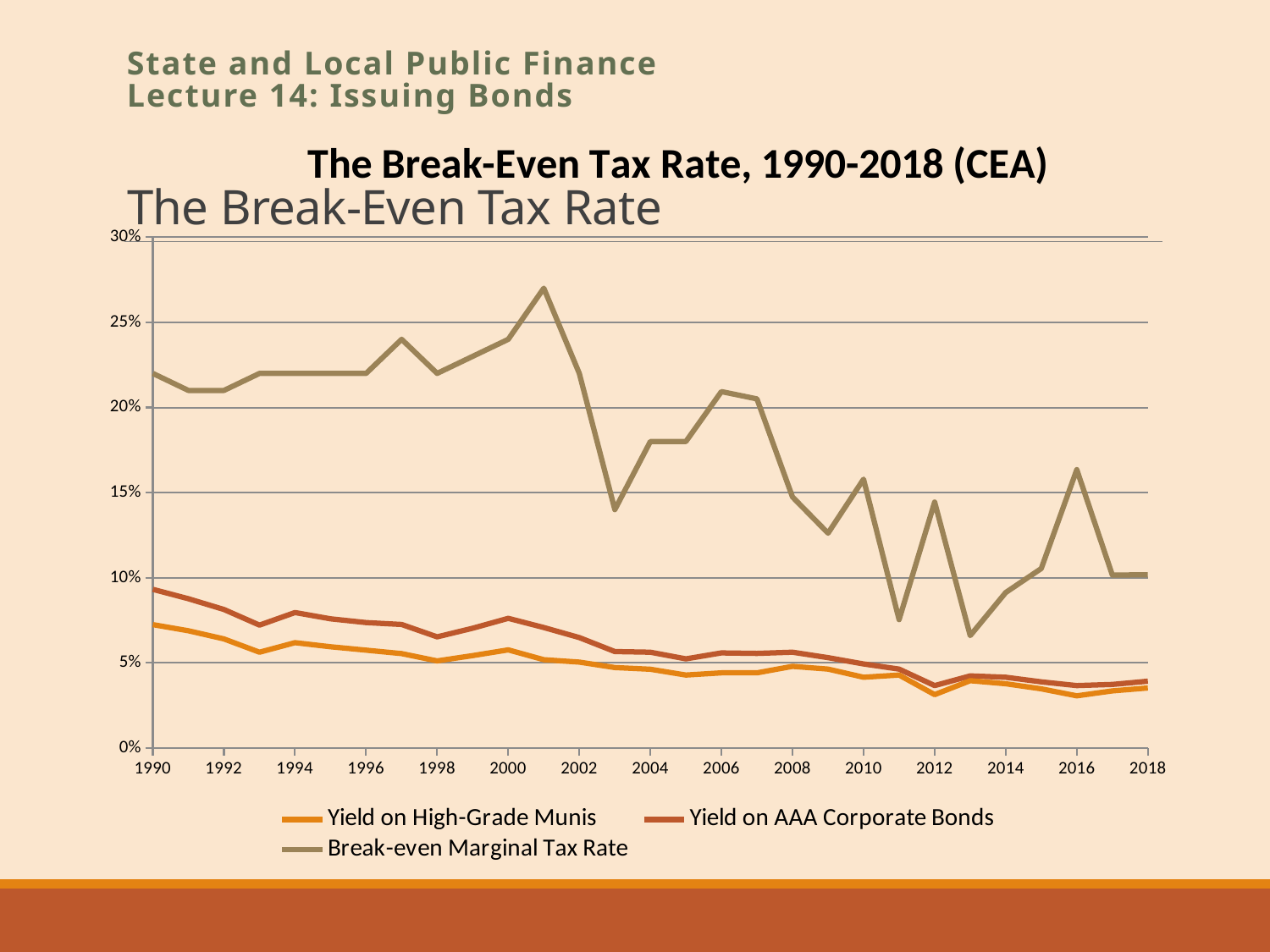
In 1990, which is higher: the Yield on AAA Corporate Bonds or the Yield on High-Grade Munis? Yield on AAA Corporate Bonds Is the Break-even Marginal Tax Rate in 2013 greater or less than 10%? less How many series does the legend list? 3 Which series is drawn in the orange line? Yield on High-Grade Munis What kind of chart is shown on the slide? line chart What is the title printed above the chart? The Break-Even Tax Rate, 1990-2018 (CEA) In which year does the Break-even Marginal Tax Rate reach its lowest value? 2013 Does the Break-even Marginal Tax Rate generally rise or fall from 1990 to 2018? fall Is the Break-even Marginal Tax Rate in 2001 greater or less than 25%? greater Is the Yield on AAA Corporate Bonds in 1990 greater or less than 10%? less In which year does the Break-even Marginal Tax Rate reach its highest value? 2001